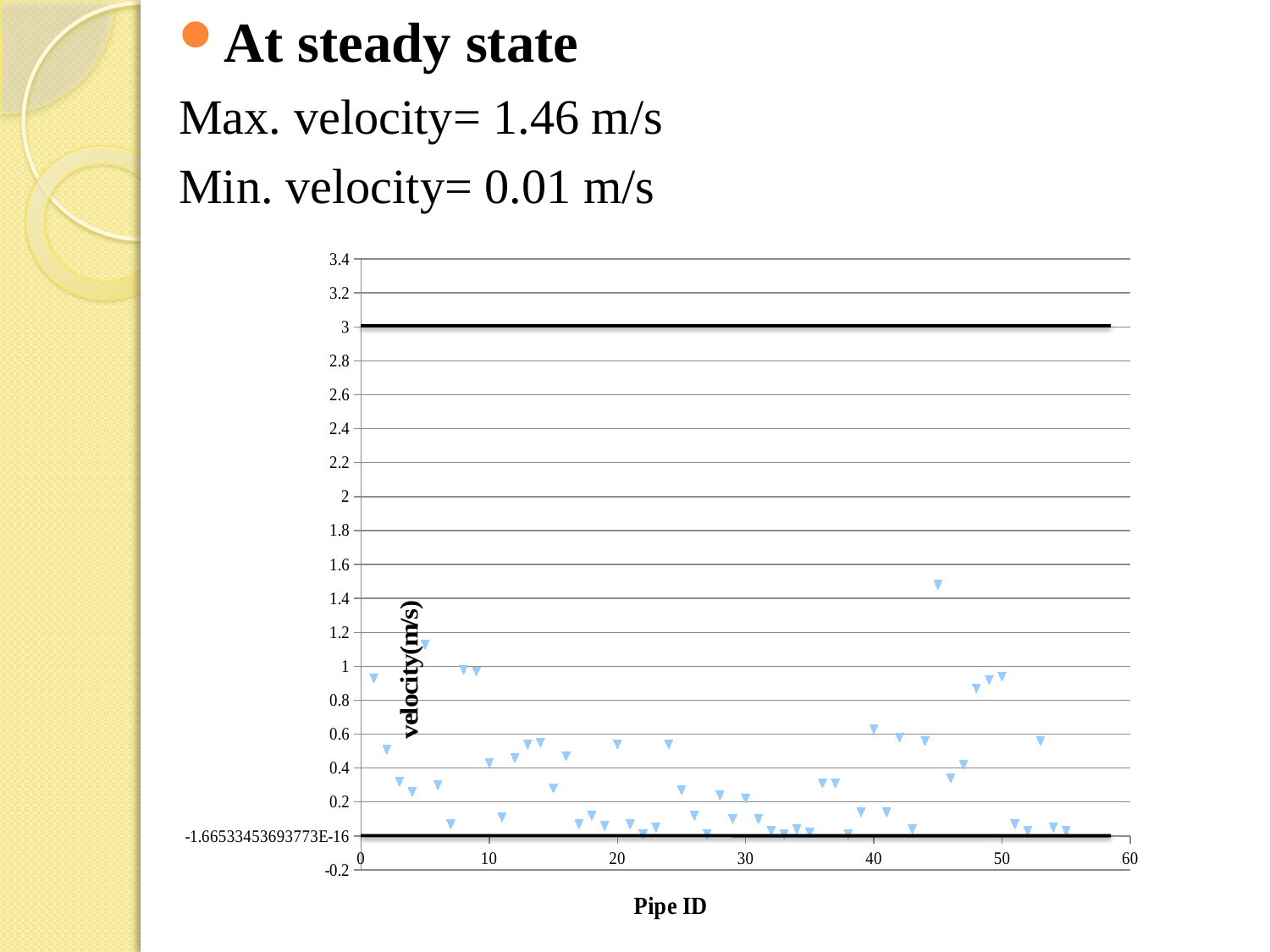
According to the slide, what is the maximum velocity at steady state? 1.46 m/s Is the velocity for the pipe at Pipe ID 45 greater or less than 1.2? greater At what velocity value is the upper horizontal black line drawn on the chart? 3 According to the slide, what is the minimum velocity at steady state? 0.01 m/s What is the title of the y axis of the chart? velocity(m/s) What is the title of the x axis of the chart? Pipe ID Is the velocity for the pipe at Pipe ID 40 greater or less than 0.8? less Is the velocity for the pipe at Pipe ID 5 greater or less than 1? greater What kind of chart is shown on the slide? scatter chart What is the highest value shown on the y axis of the chart? 3.4 Are any of the plotted velocity points above the horizontal line at 3? No